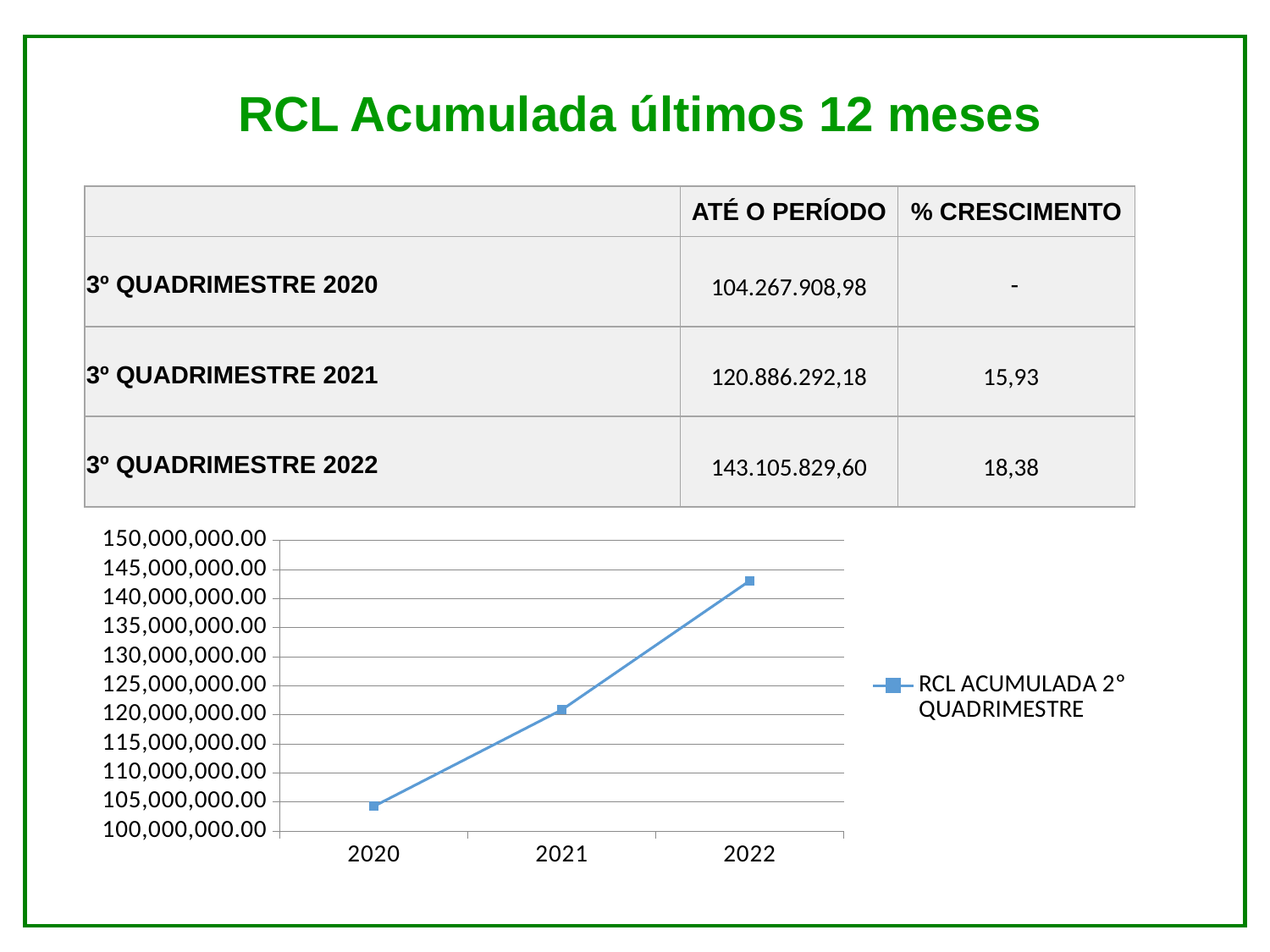
Is the value for 2022 in the line chart greater or less than 140,000,000.00? greater What is the highest value shown on the vertical axis of the line chart? 150,000,000.00 Which year has the highest value in the line chart? 2022 What is the name of the series shown in the chart legend? RCL ACUMULADA 2° QUADRIMESTRE How many series does the chart legend list? 1 Do the values in the line chart rise or fall from 2020 to 2022? rise Which year has the lowest value in the line chart? 2020 In the line chart, which is larger, the value for 2021 or the value for 2022? 2022 How many data points are plotted on the line chart? 3 What kind of chart is shown on the slide? line chart